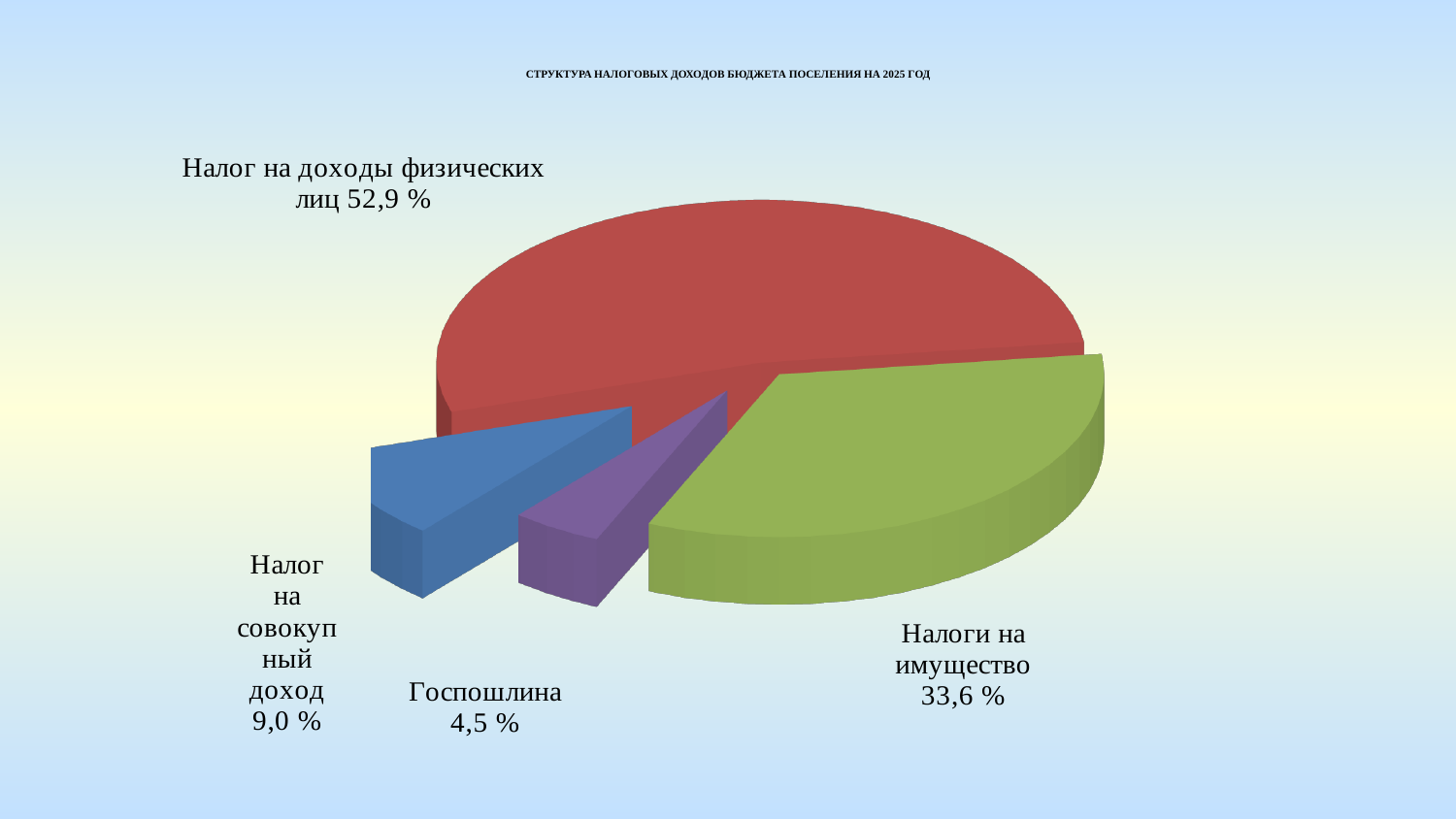
Какова доля налога на совокупный доход? 9,0 % На сколько процентных пунктов доля налога на доходы физических лиц больше доли налогов на имущество? 19,3 Какой вид налоговых доходов имеет наименьшую долю? Госпошлина Что больше: доля налога на совокупный доход или доля госпошлины? Налог на совокупный доход Какова доля налога на доходы физических лиц в структуре налоговых доходов? 52,9 % Каким цветом показан сектор «Налоги на имущество»? Зелёным Какова доля налогов на имущество? 33,6 % Сколько секторов (категорий) показано на круговой диаграмме? 4 Какой тип диаграммы показан на слайде? Круговая диаграмма Как называется диаграмма на слайде? Структура налоговых доходов бюджета поселения на 2025 год Какова доля госпошлины? 4,5 % Какой вид налоговых доходов имеет наибольшую долю? Налог на доходы физических лиц